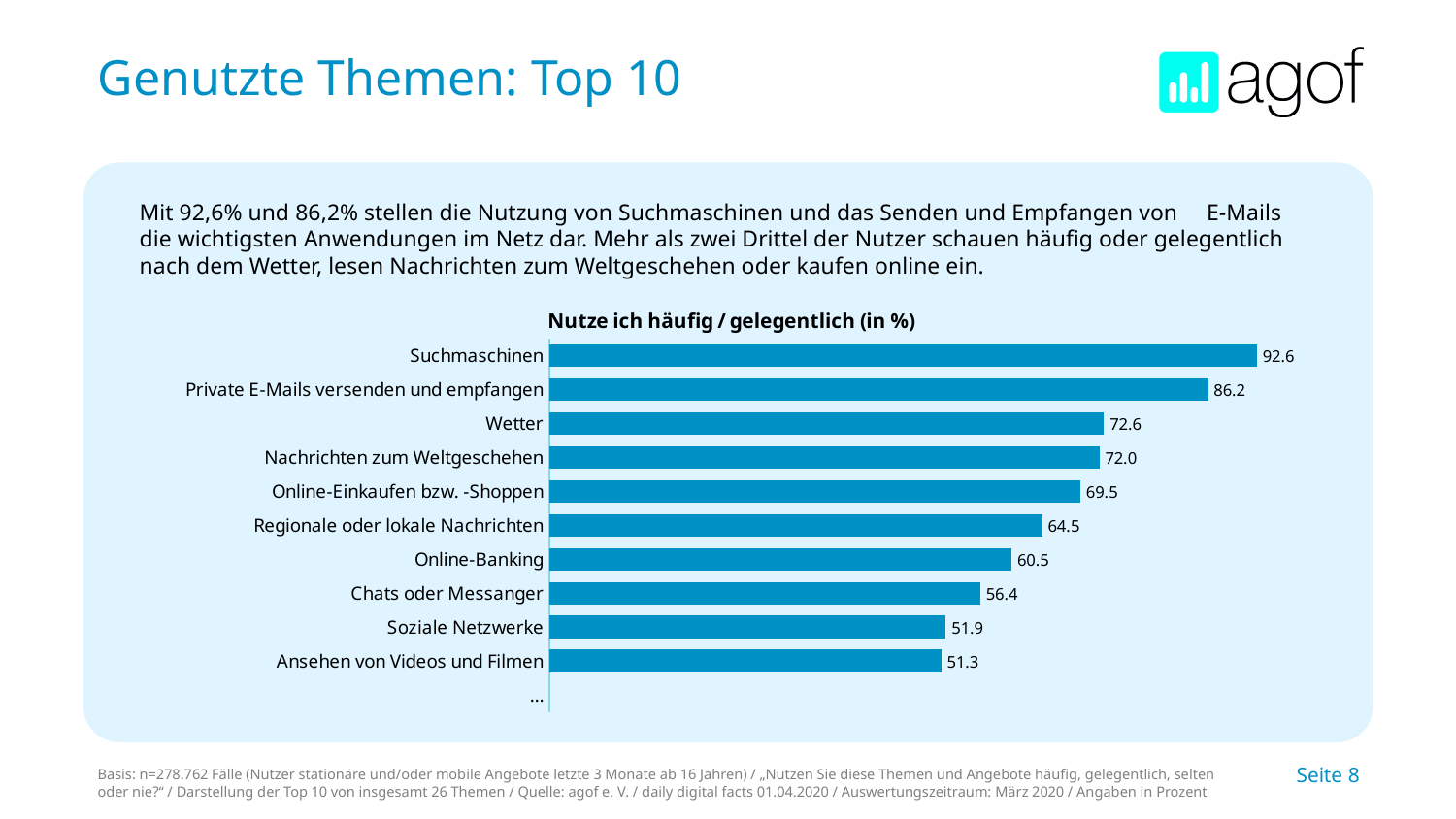
Which labelled category has the lowest value? Ansehen von Videos und Filmen What kind of chart is shown on the slide? Bar chart Which is larger, the value for Online-Einkaufen bzw. -Shoppen or the value for Chats oder Messanger? Online-Einkaufen bzw. -Shoppen What is the title of the chart? Nutze ich häufig / gelegentlich (in %) What is the value for Soziale Netzwerke? 51.9 What is the value for Regionale oder lokale Nachrichten? 64.5 What is the difference between the values for Suchmaschinen and Private E-Mails versenden und empfangen? 6.4 How many labelled categories with values are shown in the chart? 10 What is the difference between the values for Wetter and Nachrichten zum Weltgeschehen? 0.6 What is the value for Online-Banking? 60.5 What is the value for Suchmaschinen? 92.6 Which category has the highest value? Suchmaschinen